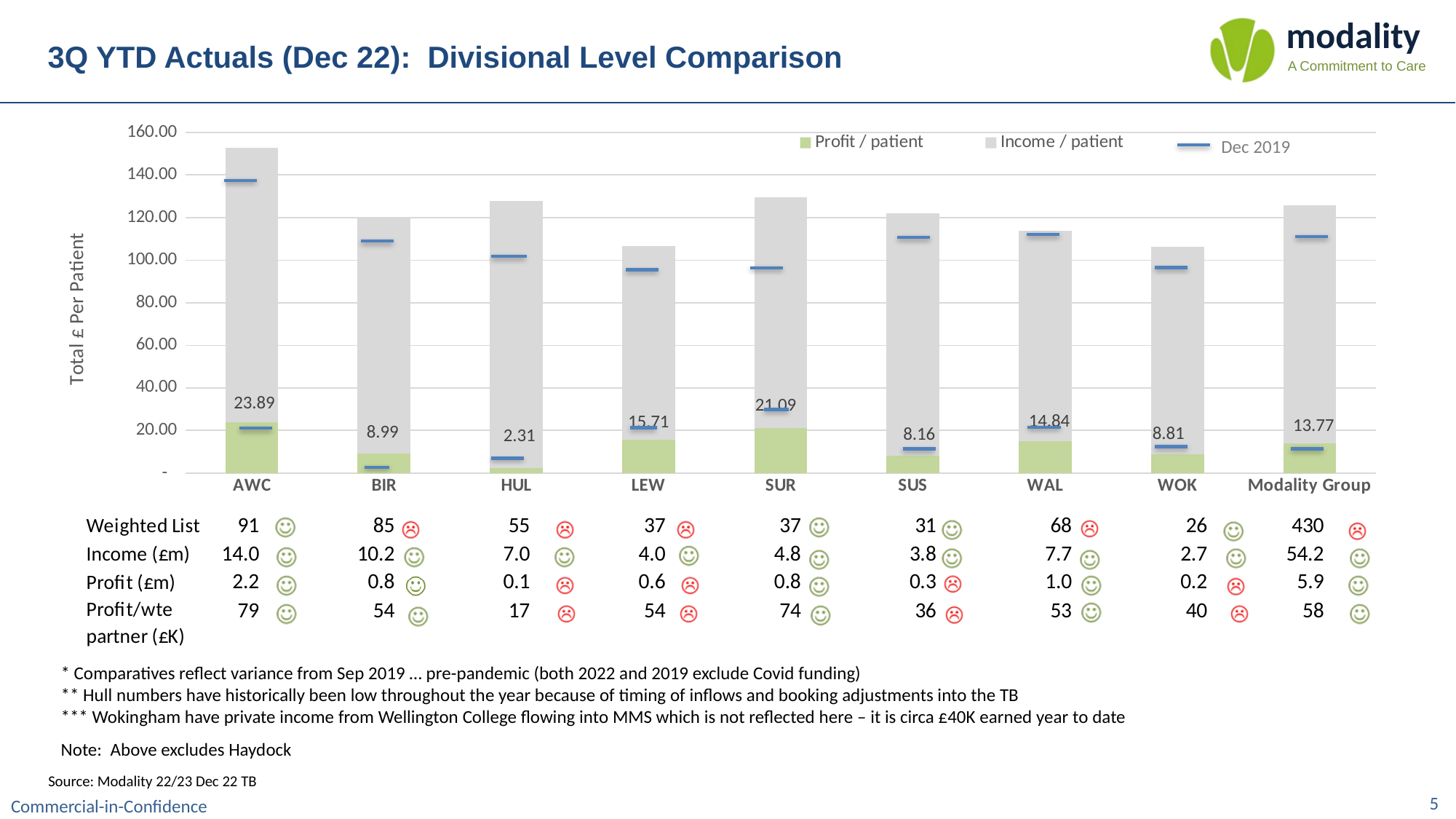
Is the total bar height for AWC greater or less than 140? greater Which division has the lowest Profit / patient? HUL What is the Profit / patient value for HUL? 2.31 What is the Profit / patient value for Modality Group? 13.77 What is the title of the vertical axis of the chart? Total £ Per Patient What is the Profit / patient value for AWC? 23.89 What is the difference between the Profit / patient values for AWC and HUL? 21.58 Which division has the highest Profit / patient? AWC How many categories are shown on the x axis of the chart? 9 Which has the larger Profit / patient, LEW or WAL? LEW How many series does the chart legend list? 3 Is the total bar height for WOK greater or less than 120? less